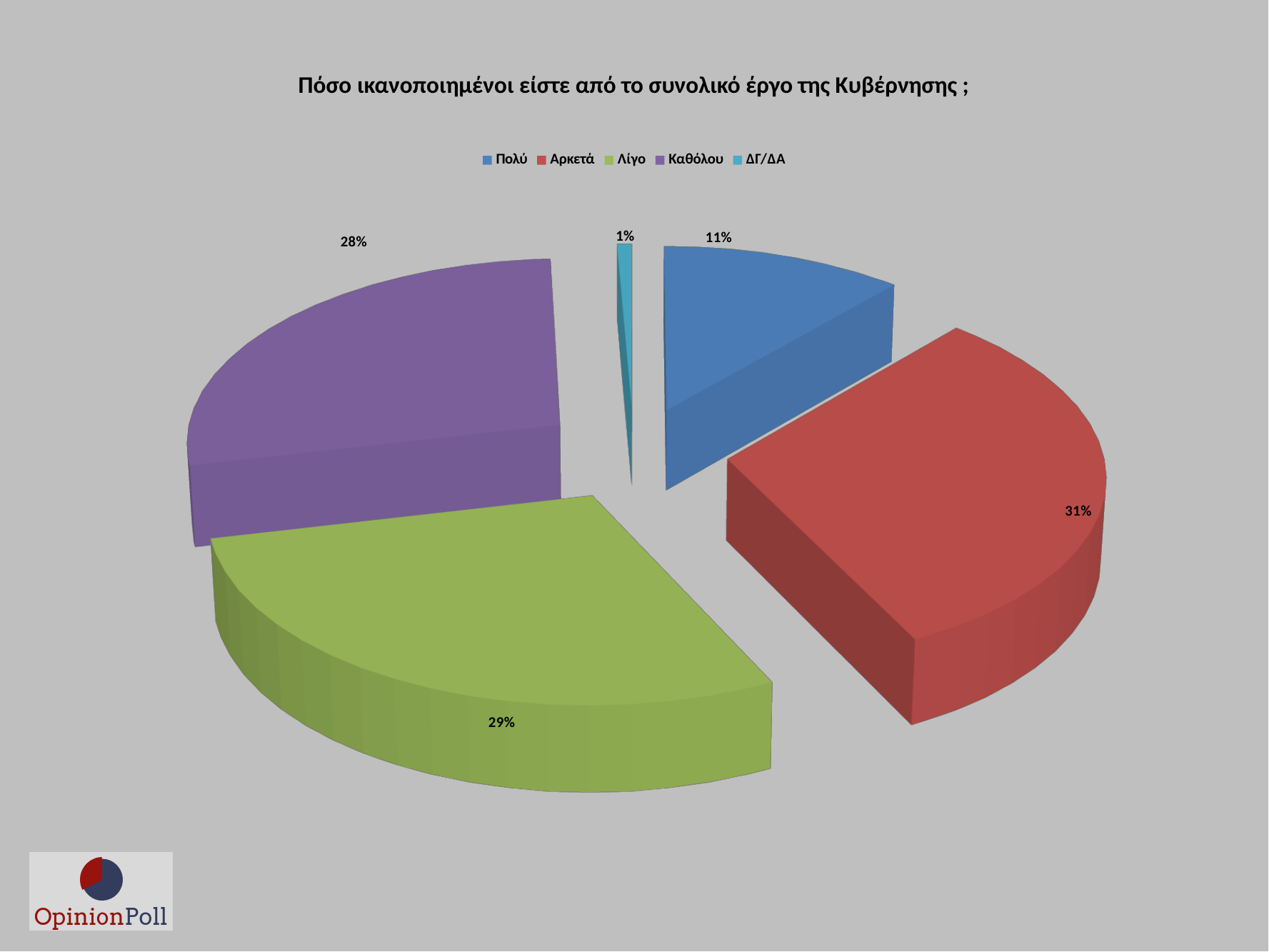
Which response category has the smallest share of the pie? ΔΓ/ΔΑ Which is larger, the share for Καθόλου or the share for Πολύ? Καθόλου What percentage of respondents answered Πολύ? 11% What is the difference in percentage points between Λίγο and Πολύ? 18 What percentage of respondents answered ΔΓ/ΔΑ? 1% What kind of chart is shown on the slide? Pie chart What is the combined share of Πολύ and Αρκετά? 42% What percentage of respondents answered Καθόλου? 28% How many categories does the pie chart show? 5 Which response category has the largest share of the pie? Αρκετά What colour is the slice for Λίγο? Green What percentage of respondents answered Αρκετά? 31%